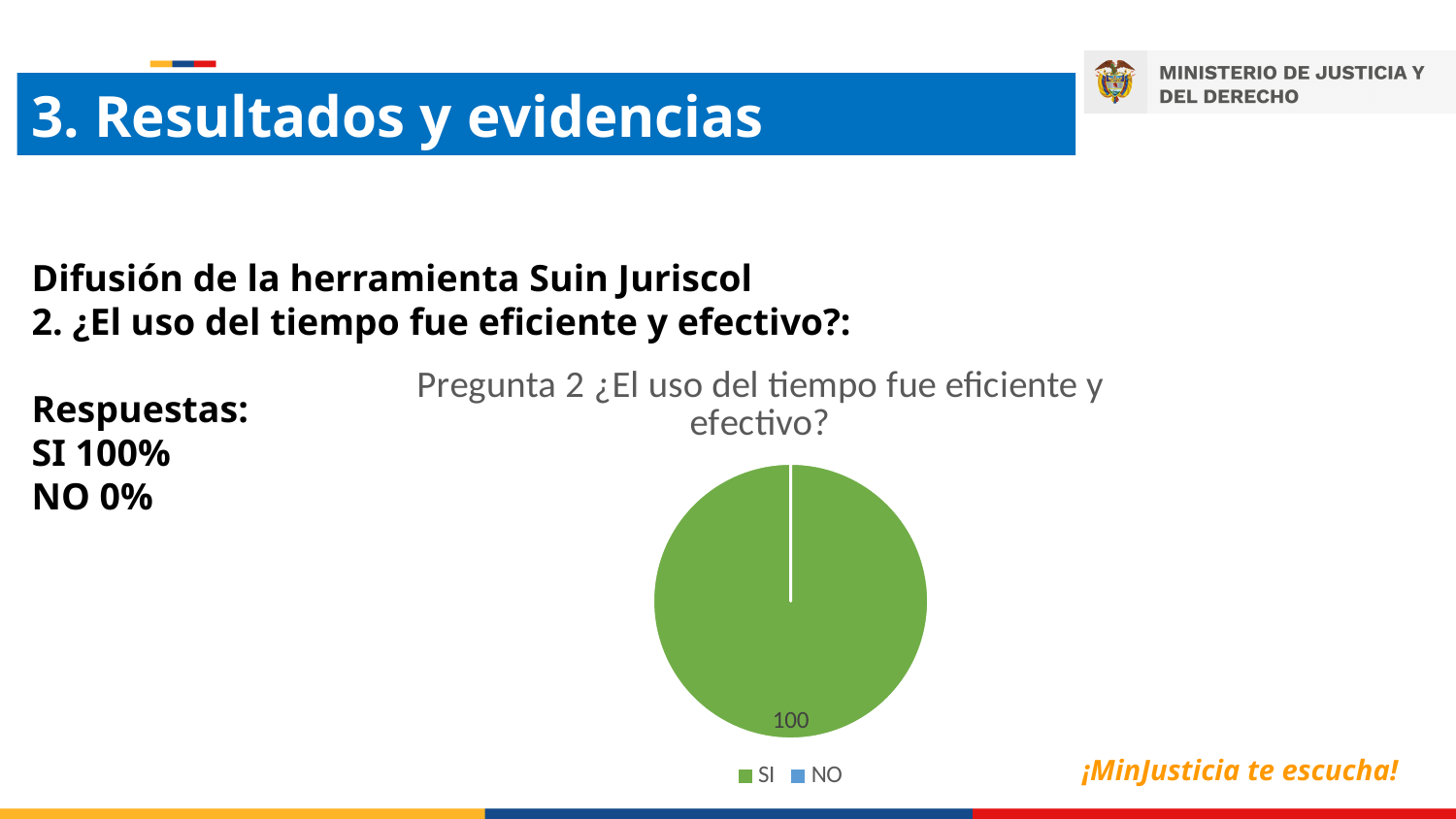
What is the title of the chart? Pregunta 2 ¿El uso del tiempo fue eficiente y efectivo? Which is larger in the pie chart, SI or NO? SI What kind of chart is shown on the slide? pie chart What data label is printed on the SI slice of the pie chart? 100 What colour represents SI in the pie chart legend? green Which category has the largest slice in the pie chart? SI What is the difference between the SI and NO percentages shown on the slide? 100% How many entries does the chart legend list? 2 What share of the pie does the NO slice represent? 0% What share of the pie does the SI slice represent? 100% Which category has the smallest share in the pie chart? NO